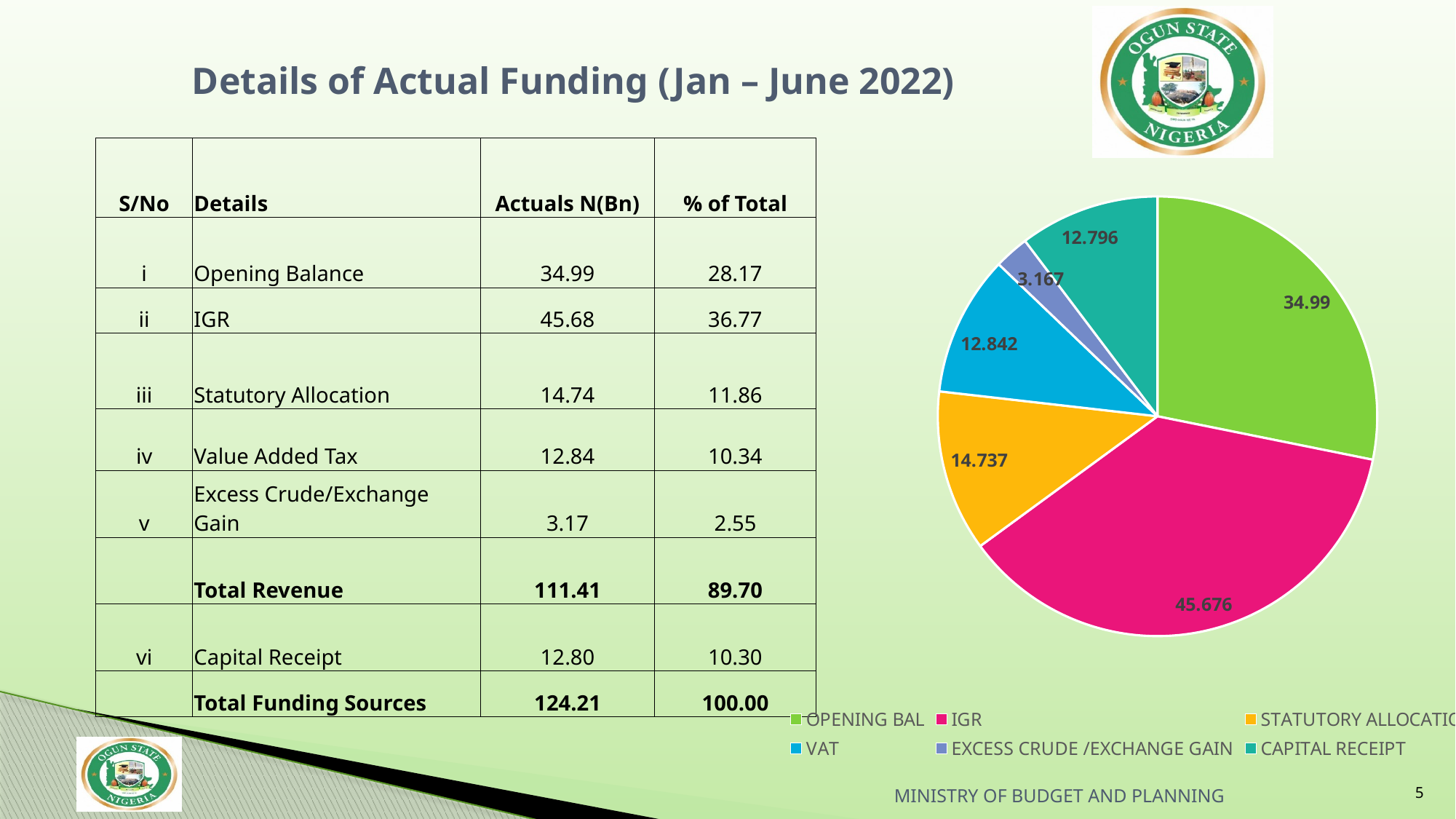
In the pie chart, which is larger: the value for STATUTORY ALLOCATION or the value for VAT? STATUTORY ALLOCATION How many slices does the pie chart have? 6 In the pie chart, what is the value for OPENING BAL? 34.99 In the pie chart, what is the difference between the IGR value and the OPENING BAL value? 10.686 In the pie chart, what is the value for CAPITAL RECEIPT? 12.796 What colour is the IGR slice in the pie chart? pink In the pie chart, what is the value for IGR? 45.676 Which category has the smallest slice in the pie chart? EXCESS CRUDE /EXCHANGE GAIN In the pie chart, what is the value for EXCESS CRUDE /EXCHANGE GAIN? 3.167 In the pie chart, what is the value for VAT? 12.842 Which category has the largest slice in the pie chart? IGR What kind of chart is shown on the slide? pie chart